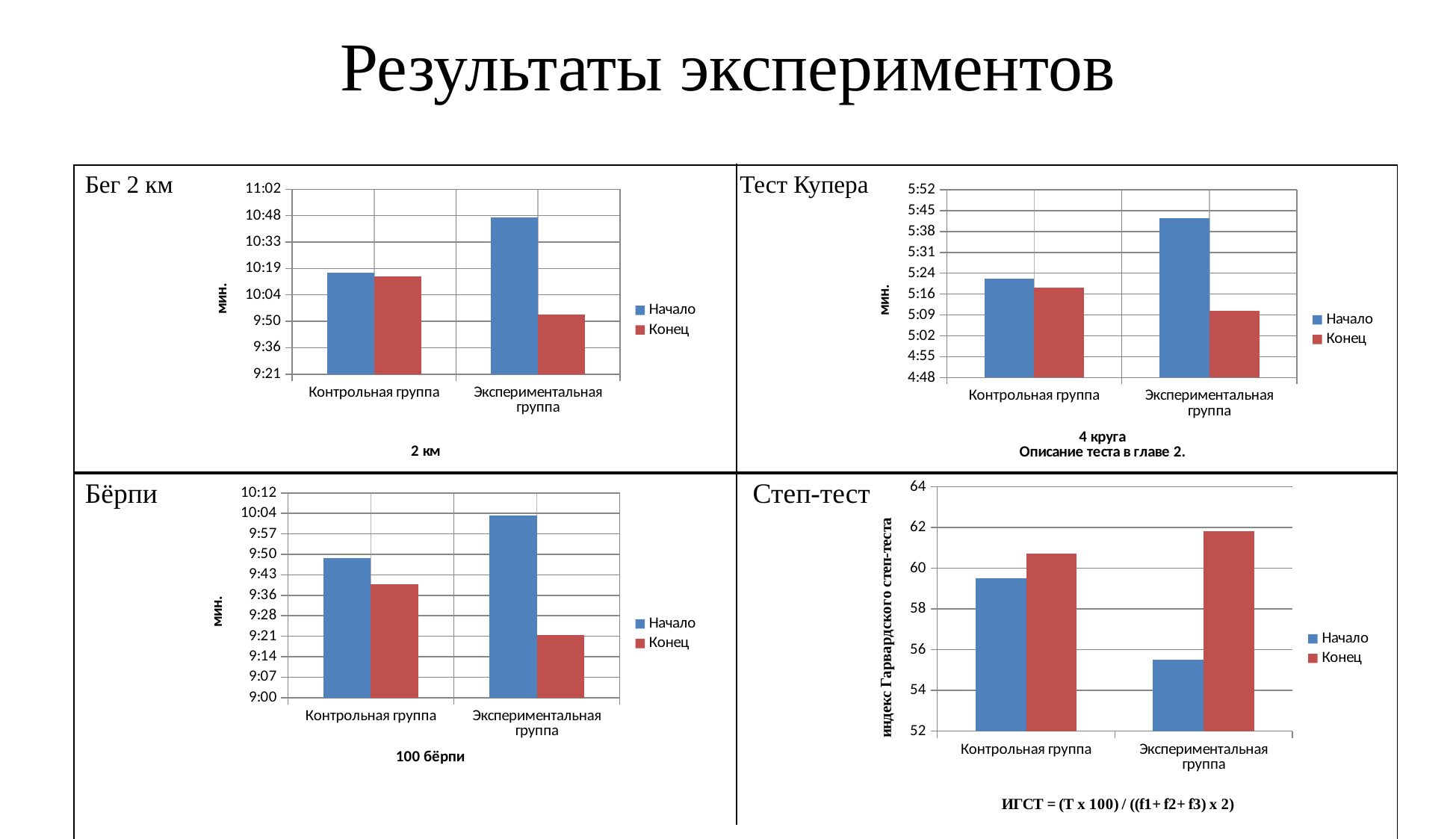
In the Тест Купера chart, is the Начало value for Экспериментальная группа greater or less than 5:38? greater How many groups are shown on the x axis of the Бёрпи chart? 2 In the Бёрпи chart, is the Конец value for Экспериментальная группа greater or less than 9:28? less In the Бёрпи chart, which series is higher for Контрольная группа, Начало or Конец? Начало What kind of chart is the Степ-тест chart? bar chart In the Степ-тест chart, which group has the higher Конец value? Экспериментальная группа How many series does the legend of the Тест Купера chart list? 2 In the Бег 2 км chart, is the Конец value for Экспериментальная группа greater or less than 10:04? less What is the y-axis label of the Степ-тест chart? индекс Гарвардского степ-теста